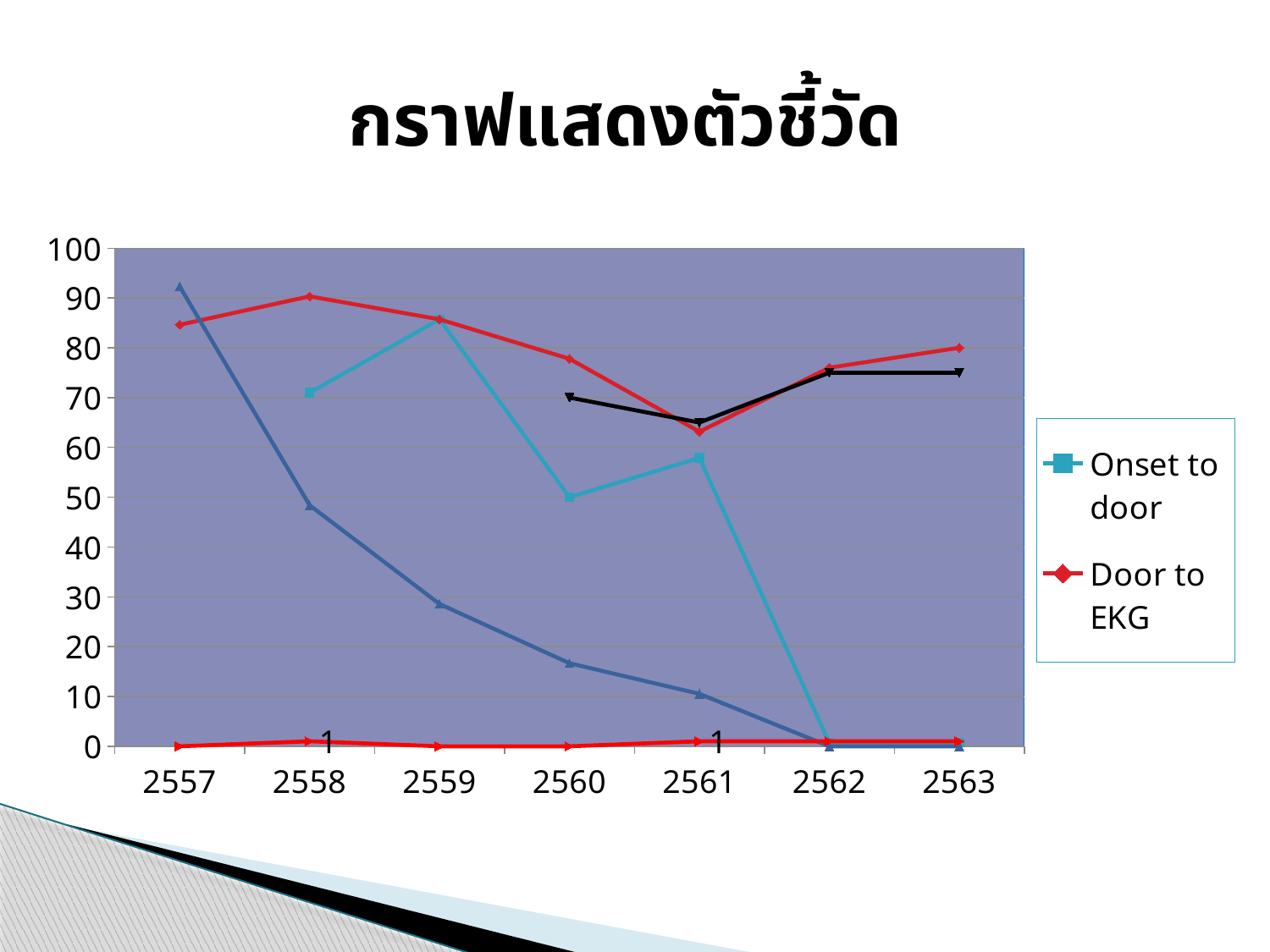
In which year is the Door to EKG series at its highest? 2558 Is the value for Door to EKG in 2561 greater or less than 70? less Is the value for Onset to door in 2562 greater or less than 10? less Is the value for Onset to door in 2559 greater or less than 80? greater In 2560, which is larger: Door to EKG or Onset to door? Door to EKG How many series does the chart's legend list? 2 What kind of chart is shown on the slide? line chart How many years are shown on the x axis of the chart? 7 What is the title of the chart? กราฟแสดงตัวชี้วัด In which year is the Door to EKG series at its lowest? 2561 Does the Door to EKG series rise or fall from 2561 to 2563? rise